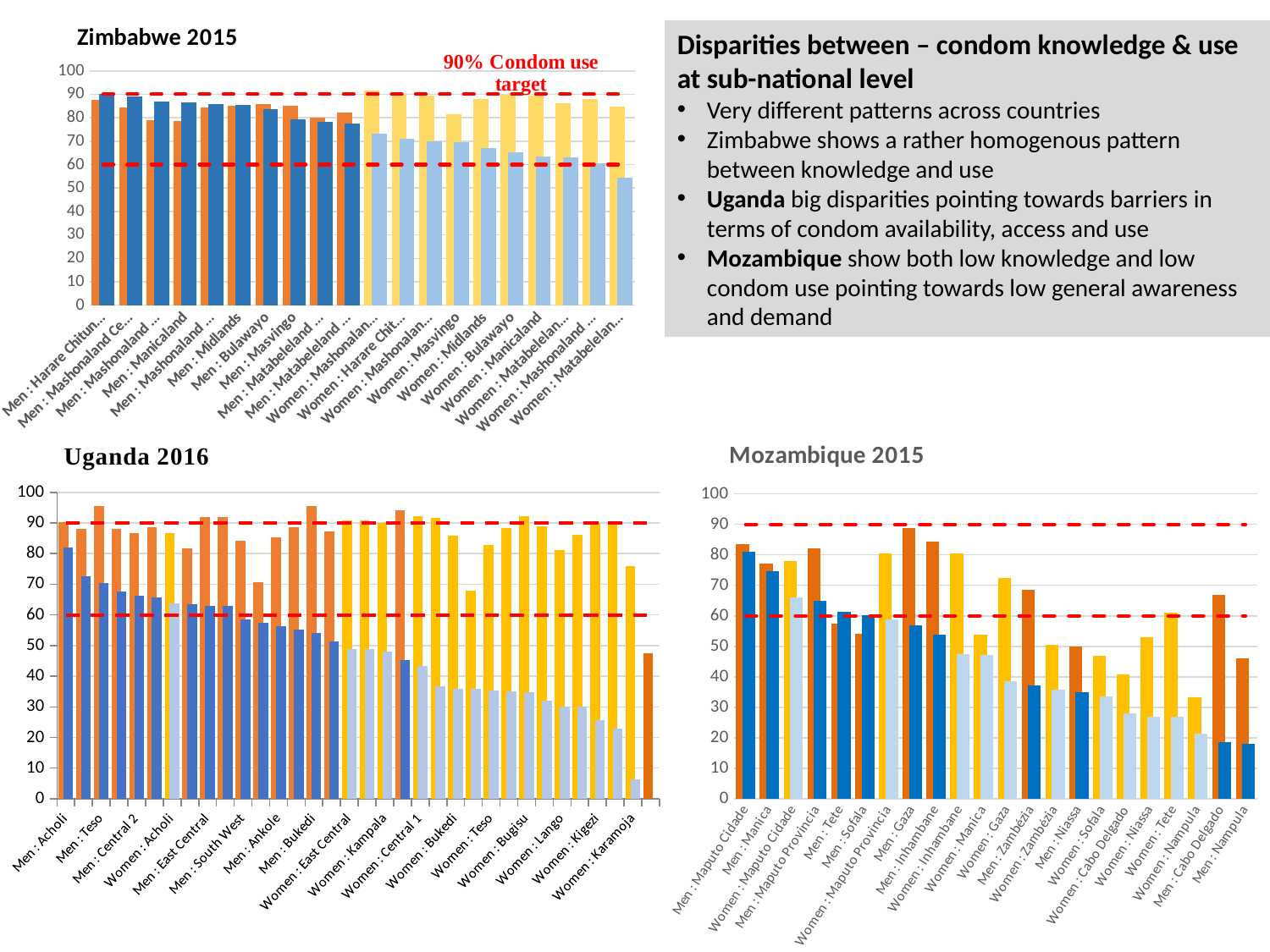
In the Mozambique 2015 chart, is the orange bar for Men: Cabo Delgado greater or less than 60? greater What is the title of the chart in the bottom-right of the slide? Mozambique 2015 In the Uganda 2016 chart, is the yellow bar for Women: Karamoja greater or less than 10? less What kind of chart is the Zimbabwe 2015 chart? bar chart In the Uganda 2016 chart, is the light blue bar for Women: Kigezi greater or less than 30? less In the Zimbabwe 2015 chart, what does the upper red dashed line represent according to its label? 90% Condom use target In the Uganda 2016 chart, do the dark blue bars generally rise or fall from left to right? fall